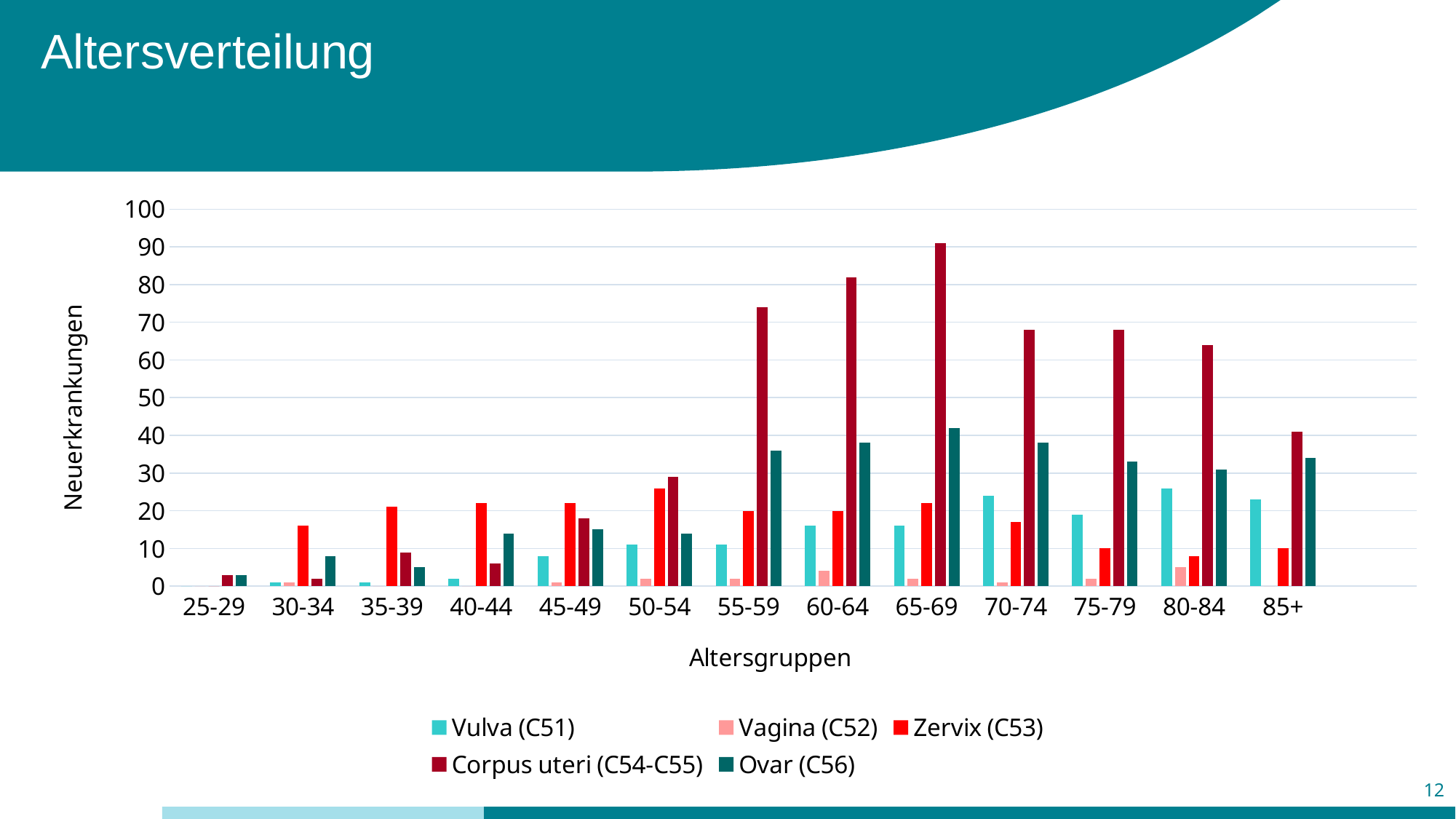
Is the value for Corpus uteri (C54-C55) in the 65-69 age group greater or less than 80? greater Is the value for Vulva (C51) in the 70-74 age group greater or less than 20? greater Is the value for Ovar (C56) in the 65-69 age group greater or less than 30? greater What is the label of the y axis? Neuerkrankungen How many series does the legend list? 5 In which age group is the value for Corpus uteri (C54-C55) highest? 65-69 How many age groups are shown on the x axis? 13 What kind of chart is shown on the slide? bar chart In which age group is the value for Ovar (C56) highest? 65-69 In the 60-64 age group, which is larger: Corpus uteri (C54-C55) or Ovar (C56)? Corpus uteri (C54-C55) In the 40-44 age group, which is larger: Zervix (C53) or Corpus uteri (C54-C55)? Zervix (C53)